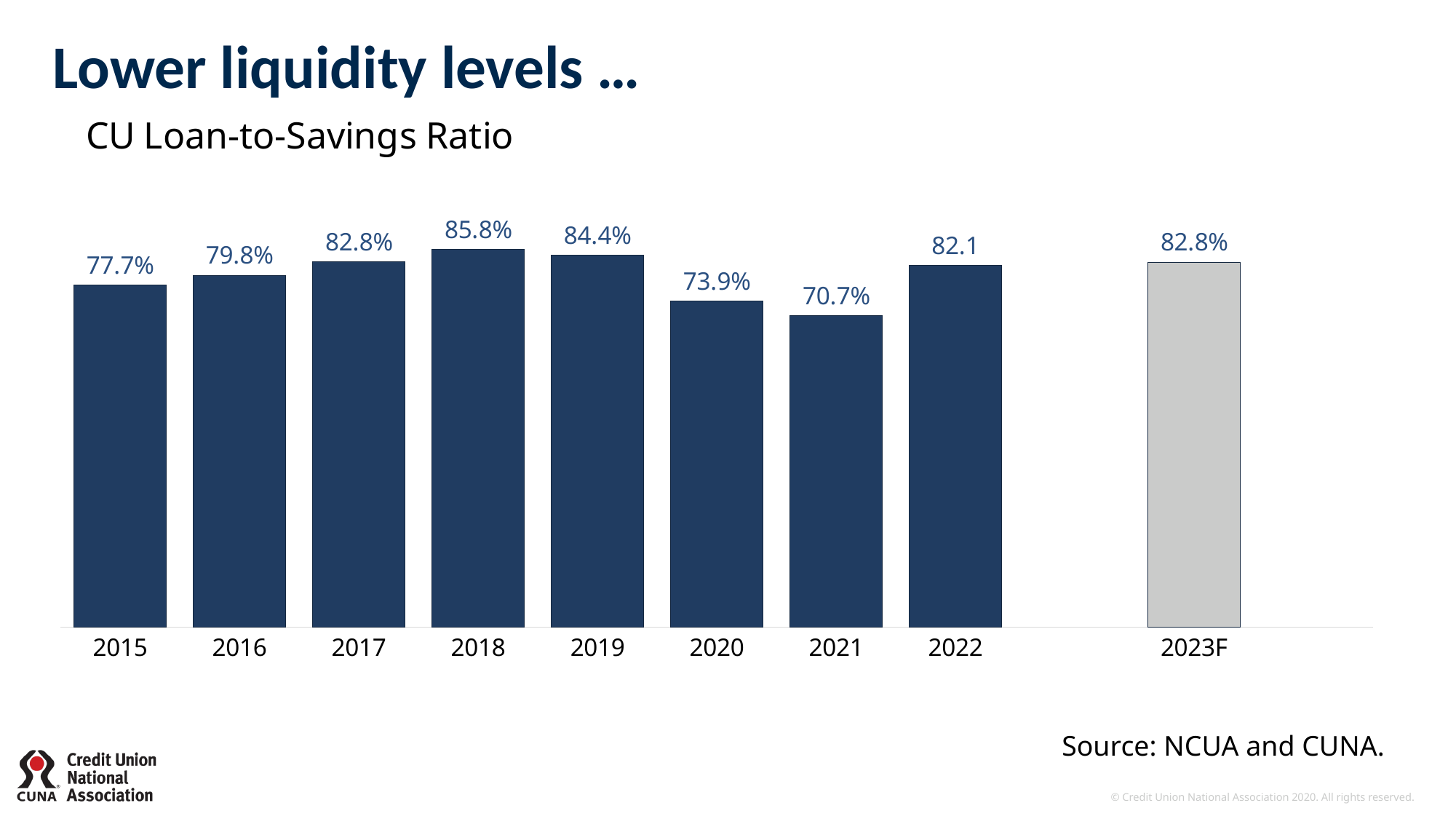
What is the difference between the 2018 and 2021 loan-to-savings ratios? 15.1 percentage points Did the loan-to-savings ratio rise or fall from 2019 to 2021? Fall Which year has the lowest loan-to-savings ratio? 2021 What is the CU loan-to-savings ratio for 2018? 85.8% Which year has the highest loan-to-savings ratio? 2018 Which year has a higher loan-to-savings ratio, 2019 or 2020? 2019 How many years are shown on the x axis? 9 What is the CU loan-to-savings ratio for 2021? 70.7% What value is shown for 2022? 82.1 What value is shown for 2023F? 82.8% What is the title of the chart? CU Loan-to-Savings Ratio What kind of chart is shown on the slide? Bar chart